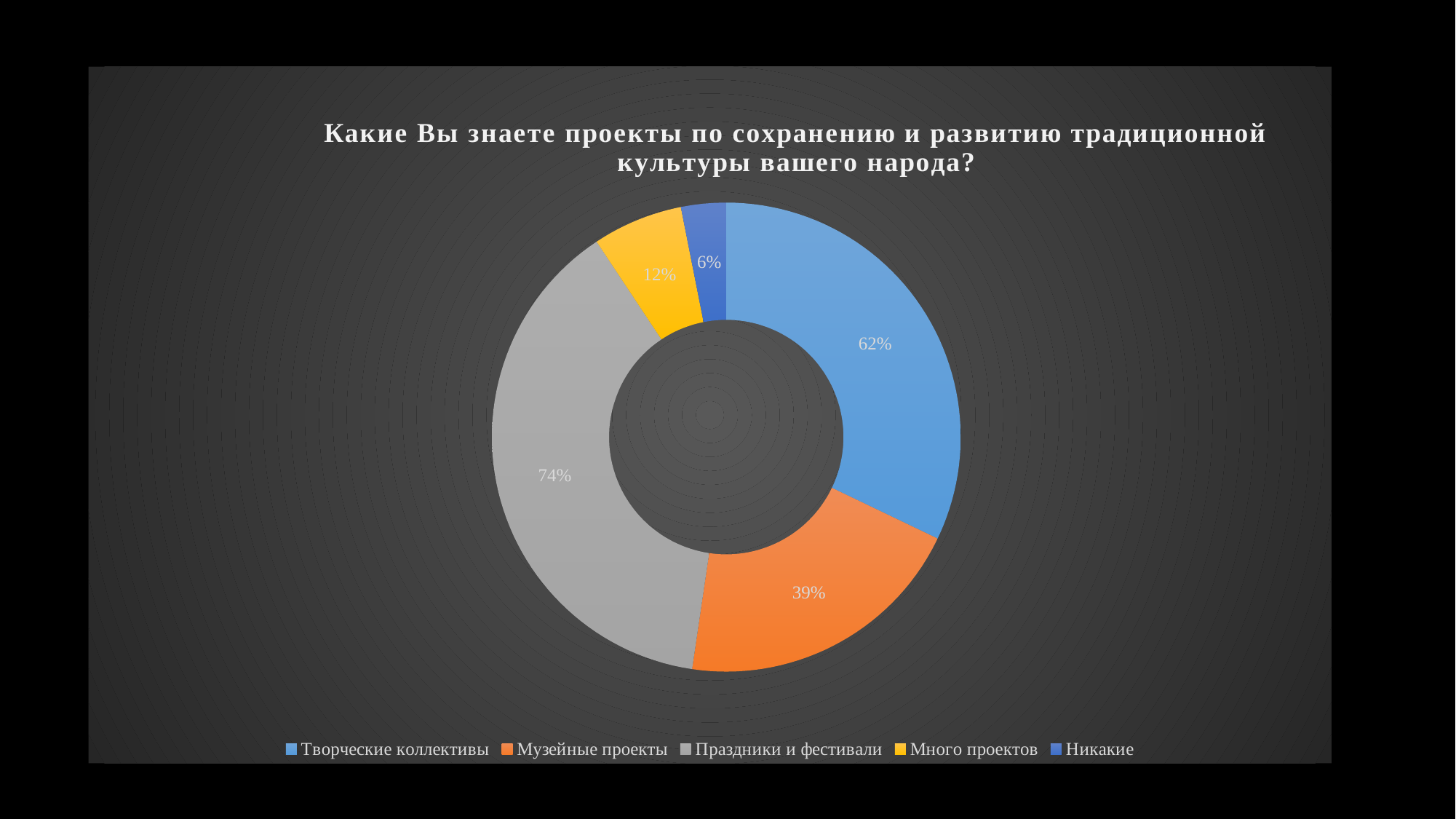
What is the value shown for Музейные проекты? 39% What is the value shown for Творческие коллективы? 62% What is the value shown for Праздники и фестивали? 74% What is the value shown for Много проектов? 12% Which is larger, the value for Музейные проекты or the value for Много проектов? Музейные проекты Which category has the lowest value? Никакие What colour is the segment for Праздники и фестивали? Grey How many categories does the legend list? 5 What kind of chart is shown on the slide? Doughnut chart Which category has the highest value? Праздники и фестивали What is the difference between the values for Праздники и фестивали and Творческие коллективы? 12% What is the value shown for Никакие? 6%